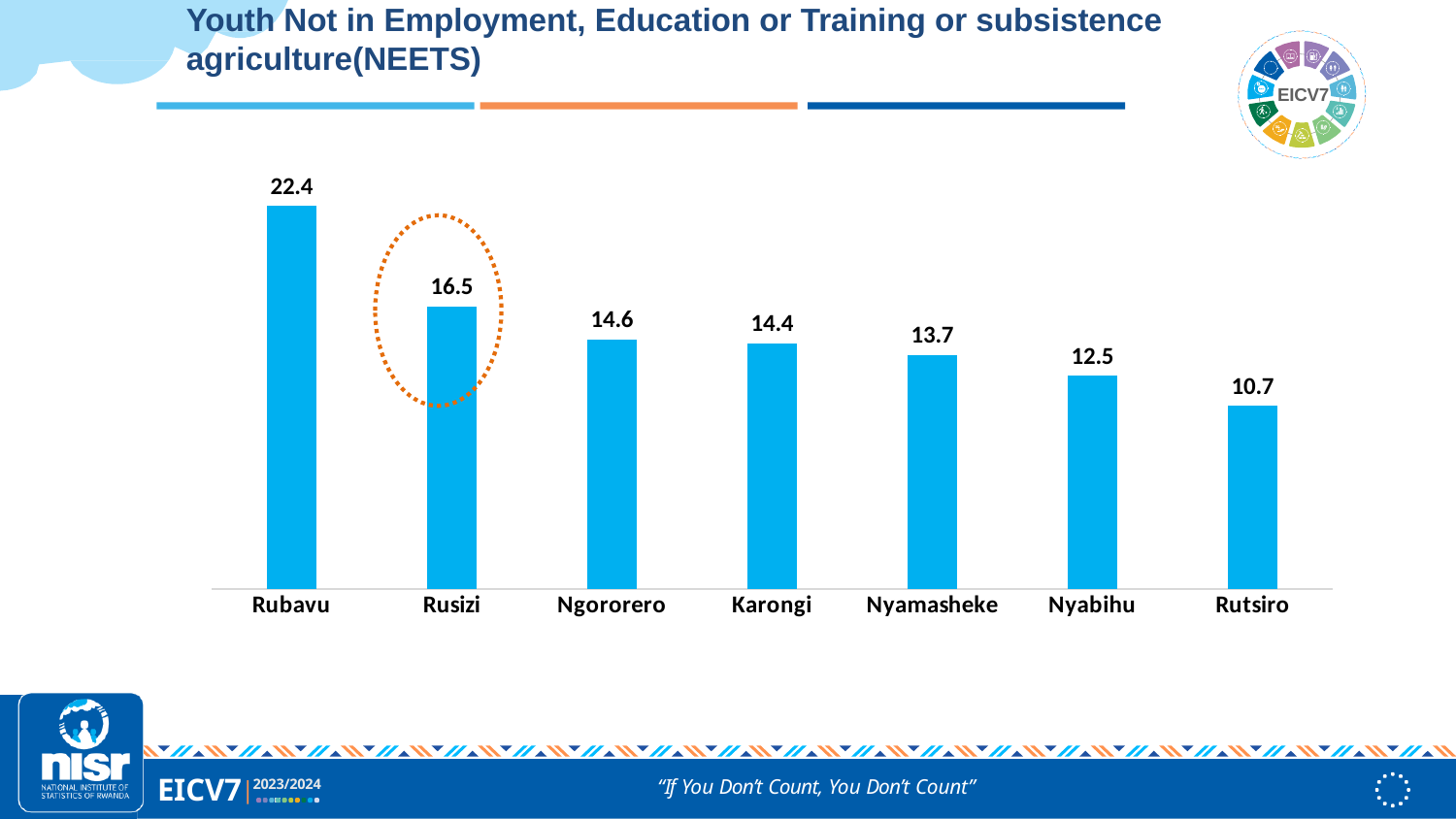
Which is larger, the value for Ngororero or the value for Nyabihu? Ngororero What is the difference between the values for Rubavu and Rusizi? 5.9 What is the value for Rutsiro? 10.7 How many districts are shown in the chart? 7 What is the value for Rusizi? 16.5 Which district has the highest value? Rubavu What is the difference between the values for Nyabihu and Rutsiro? 1.8 What kind of chart is shown on the slide? Bar chart Which district has the lowest value? Rutsiro Do the values rise or fall from left to right along the x axis? Fall Which district's bar is circled with a dotted orange outline? Rusizi What is the value for Nyamasheke? 13.7